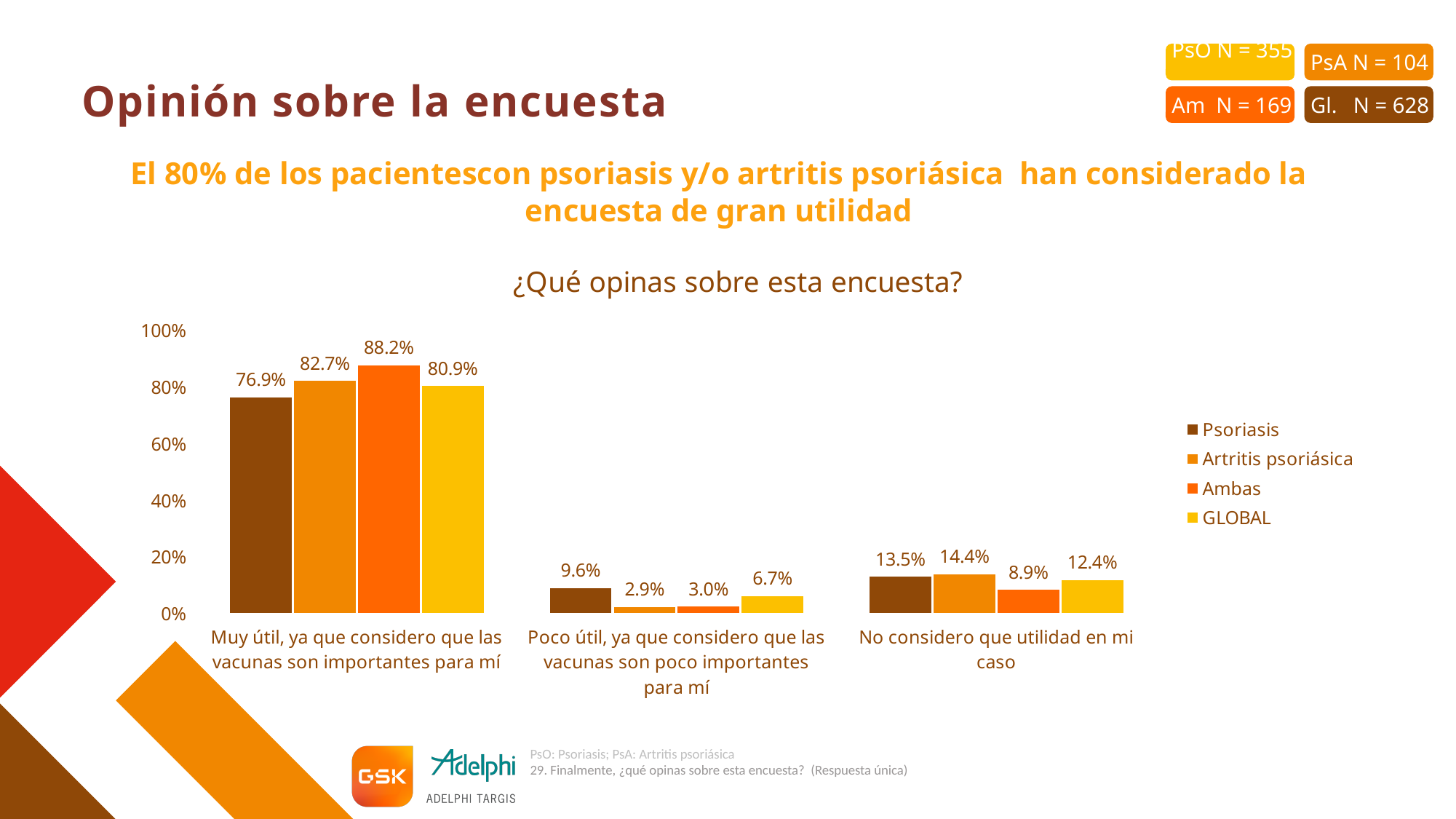
Which series has the highest value in the category "Muy útil, ya que considero que las vacunas son importantes para mí"? Ambas What kind of chart is shown on the slide? Bar chart Which is larger: the Psoriasis value or the GLOBAL value for "Poco útil, ya que considero que las vacunas son poco importantes para mí"? Psoriasis How many categories are shown on the x axis of the chart? 3 What is the value for Ambas in the category "Muy útil, ya que considero que las vacunas son importantes para mí"? 88.2% What is the difference between the Artritis psoriásica and Ambas values in the category "No considero que utilidad en mi caso"? 5.5% Which series has the lowest value in the category "Poco útil, ya que considero que las vacunas son poco importantes para mí"? Artritis psoriásica How many series does the chart legend list? 4 Is the Artritis psoriásica value for "Muy útil, ya que considero que las vacunas son importantes para mí" greater or less than 80%? greater What is the difference between the Ambas and Psoriasis values in the category "Muy útil, ya que considero que las vacunas son importantes para mí"? 11.3% What is the value for Psoriasis in the category "No considero que utilidad en mi caso"? 13.5% What is the GLOBAL value for "Poco útil, ya que considero que las vacunas son poco importantes para mí"? 6.7%